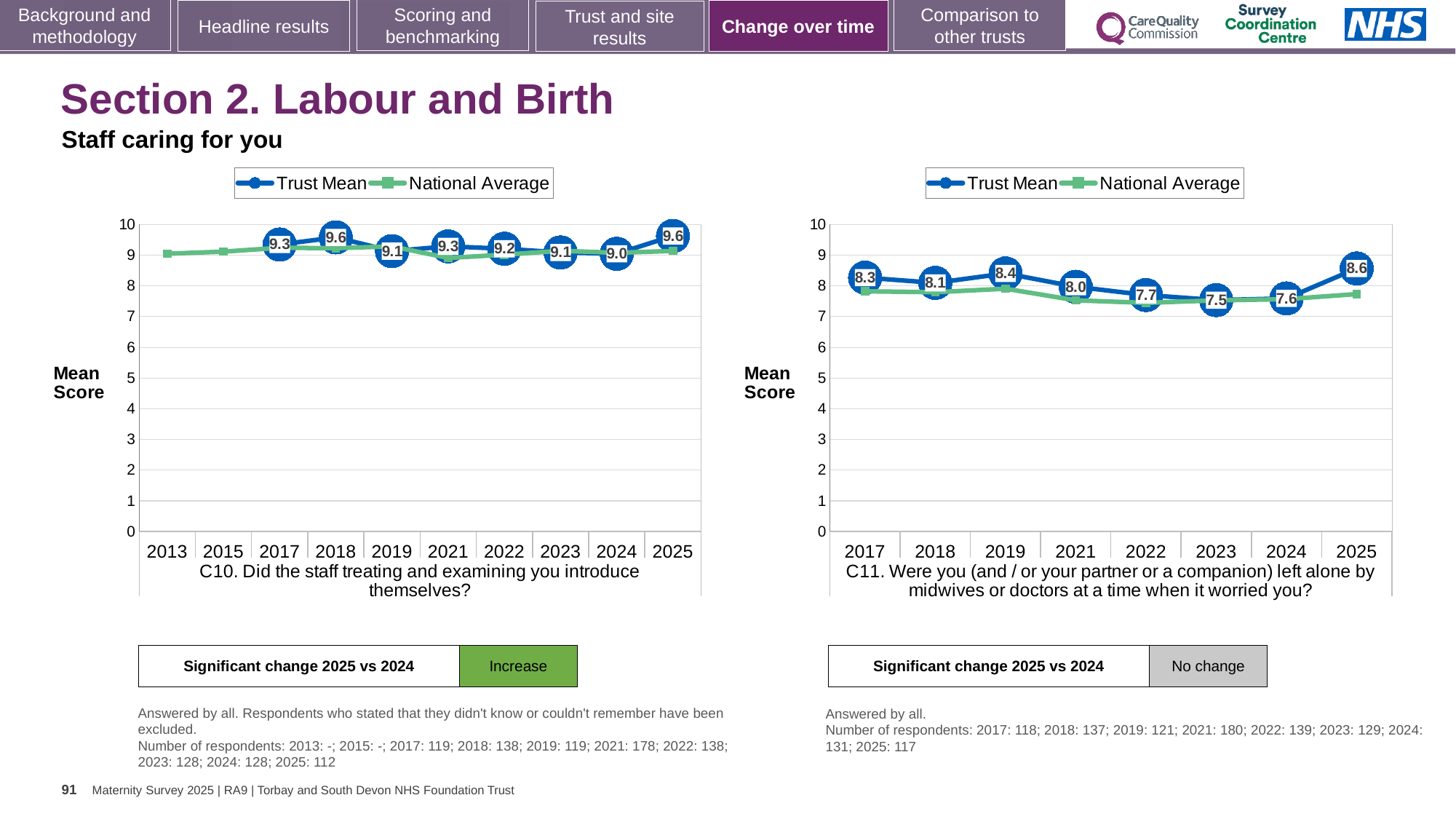
In the C11 chart on the right, is the National Average value for 2025 greater or less than 7? greater In the C10 chart on the left, what is the Trust Mean score for 2025? 9.6 In the C10 chart on the left, how many years are shown on the x axis? 10 In the C11 chart on the right, which year has the lowest Trust Mean score? 2023 In the C11 chart on the right, is the Trust Mean score for 2019 higher or lower than for 2018? higher In the C11 chart on the right, which year has the highest Trust Mean score? 2025 In the C11 chart on the right, what is the Trust Mean score for 2023? 7.5 In the C10 chart on the left, what is the Trust Mean score for 2024? 9.0 How many series does the legend of the C11 chart on the right list? 2 In the C10 chart on the left, what is the difference between the Trust Mean scores for 2025 and 2024? 0.6 In the C10 chart on the left, which year has the lowest labelled Trust Mean score? 2024 In the C11 chart on the right, what is the difference between the Trust Mean scores for 2025 and 2024? 1.0